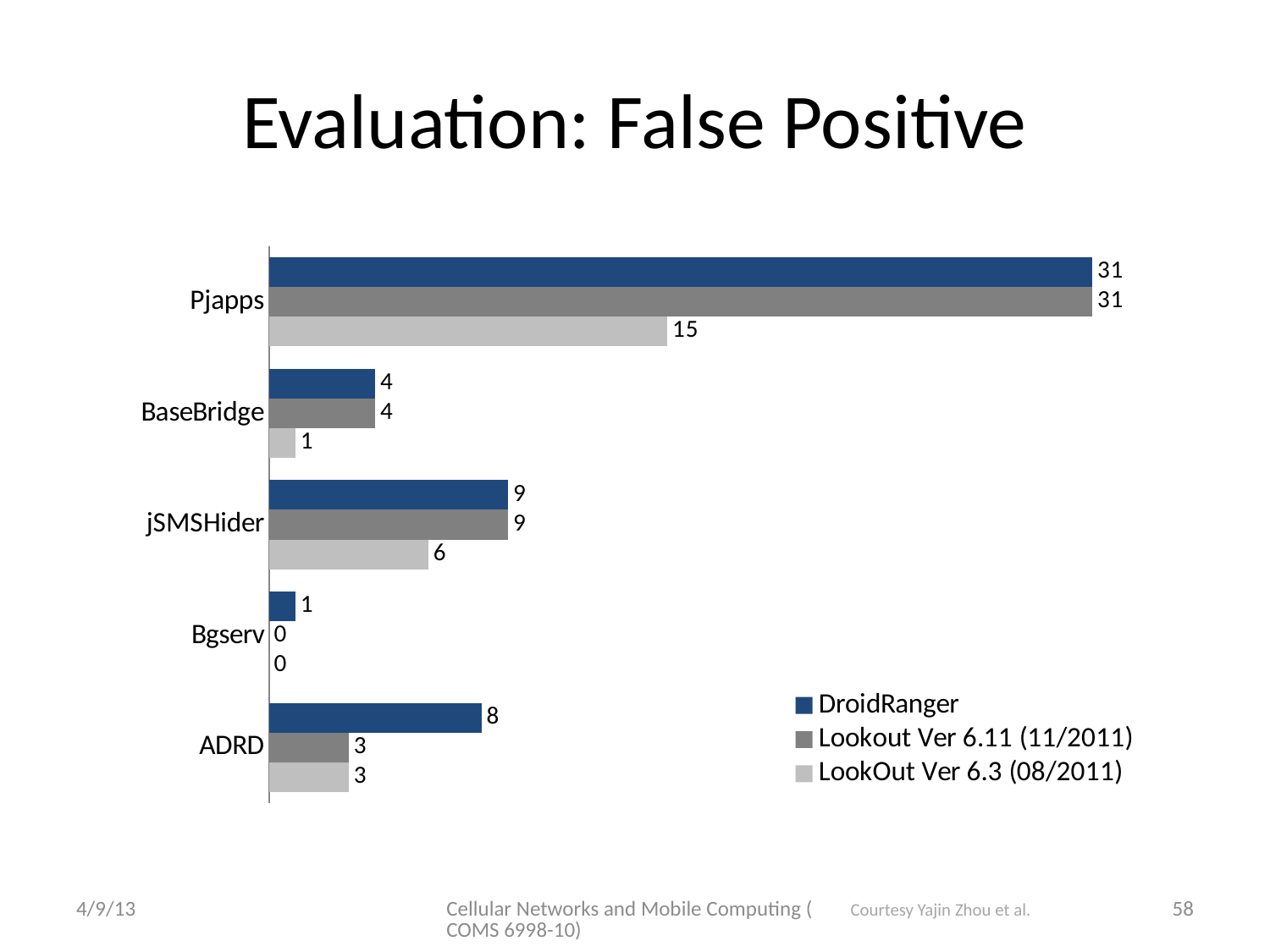
How many categories are shown on the chart? 5 What is the LookOut Ver 6.3 (08/2011) value for jSMSHider? 6 What is the title of the slide containing the chart? Evaluation: False Positive Which category has the lowest LookOut Ver 6.3 (08/2011) value? Bgserv What kind of chart is shown on the slide? bar chart What is the difference between the DroidRanger values for jSMSHider and BaseBridge? 5 For ADRD, which series has the larger value: DroidRanger or Lookout Ver 6.11 (11/2011)? DroidRanger What is the difference between the DroidRanger and LookOut Ver 6.3 (08/2011) values for Pjapps? 16 Which category has the highest DroidRanger value? Pjapps How many series does the legend list? 3 What is the Lookout Ver 6.11 (11/2011) value for ADRD? 3 What is the DroidRanger value for Pjapps? 31